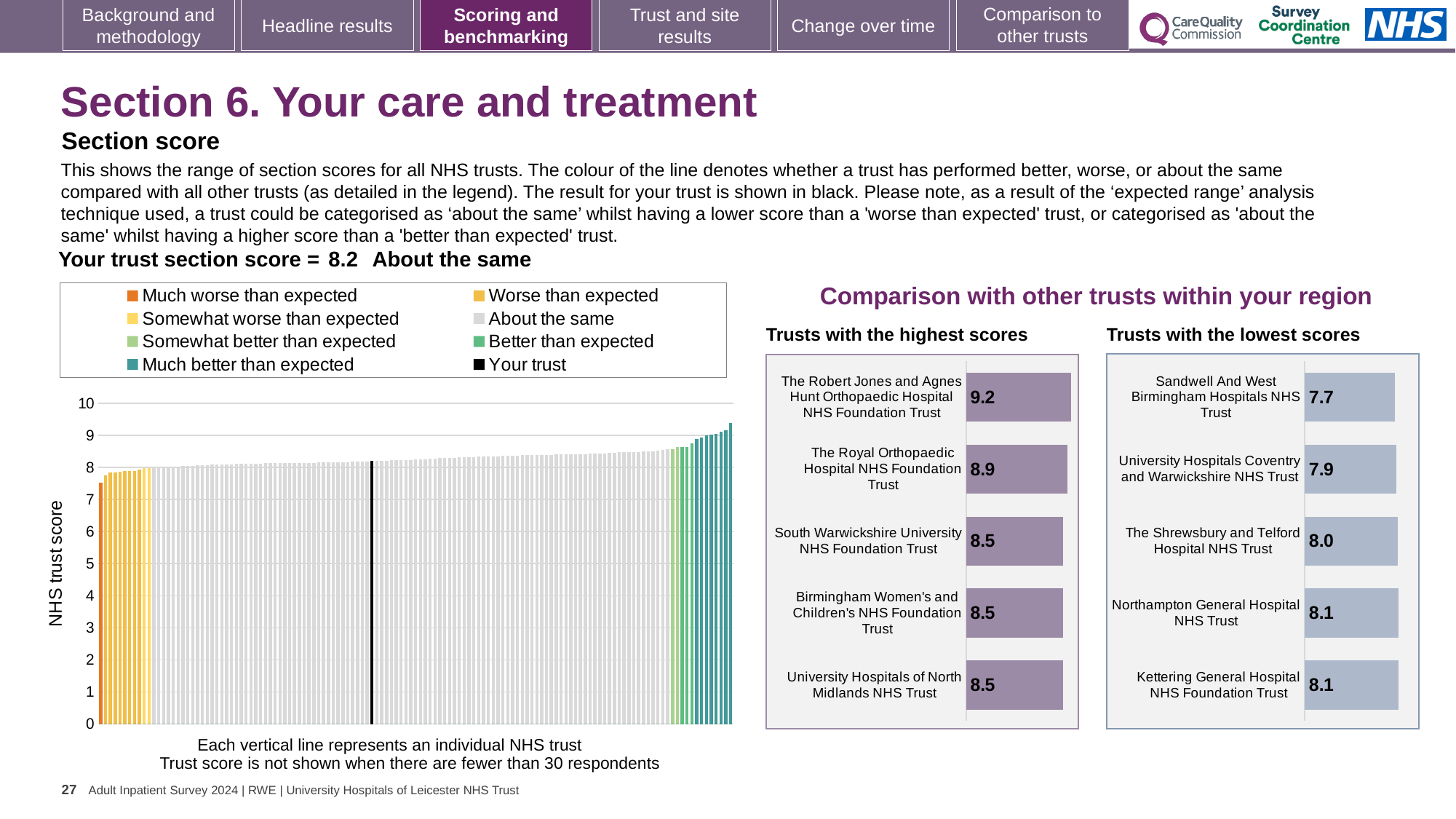
In the 'Trusts with the highest scores' chart, which trust has the highest score? The Robert Jones and Agnes Hunt Orthopaedic Hospital NHS Foundation Trust In the main 'NHS trust score' chart, do the trust scores rise or fall from left to right? Rise In the 'Trusts with the highest scores' chart, what is the difference between the scores of The Robert Jones and Agnes Hunt Orthopaedic Hospital NHS Foundation Trust and The Royal Orthopaedic Hospital NHS Foundation Trust? 0.3 How many trusts are shown in the 'Trusts with the lowest scores' chart? 5 In the 'Trusts with the lowest scores' chart, which trust has the lowest score? Sandwell And West Birmingham Hospitals NHS Trust In the 'Trusts with the lowest scores' chart, what is the score for Sandwell And West Birmingham Hospitals NHS Trust? 7.7 What kind of chart is the main chart showing the NHS trust scores for all trusts? Bar chart In the 'Trusts with the highest scores' chart, what is the score for The Royal Orthopaedic Hospital NHS Foundation Trust? 8.9 How many entries does the legend of the main 'NHS trust score' chart list? 8 In the 'Trusts with the lowest scores' chart, which has the larger score: University Hospitals Coventry and Warwickshire NHS Trust or The Shrewsbury and Telford Hospital NHS Trust? The Shrewsbury and Telford Hospital NHS Trust In the main 'NHS trust score' chart, is the value for the black bar (your trust) greater or less than 8? greater In the 'Trusts with the highest scores' chart, what is the score for The Robert Jones and Agnes Hunt Orthopaedic Hospital NHS Foundation Trust? 9.2